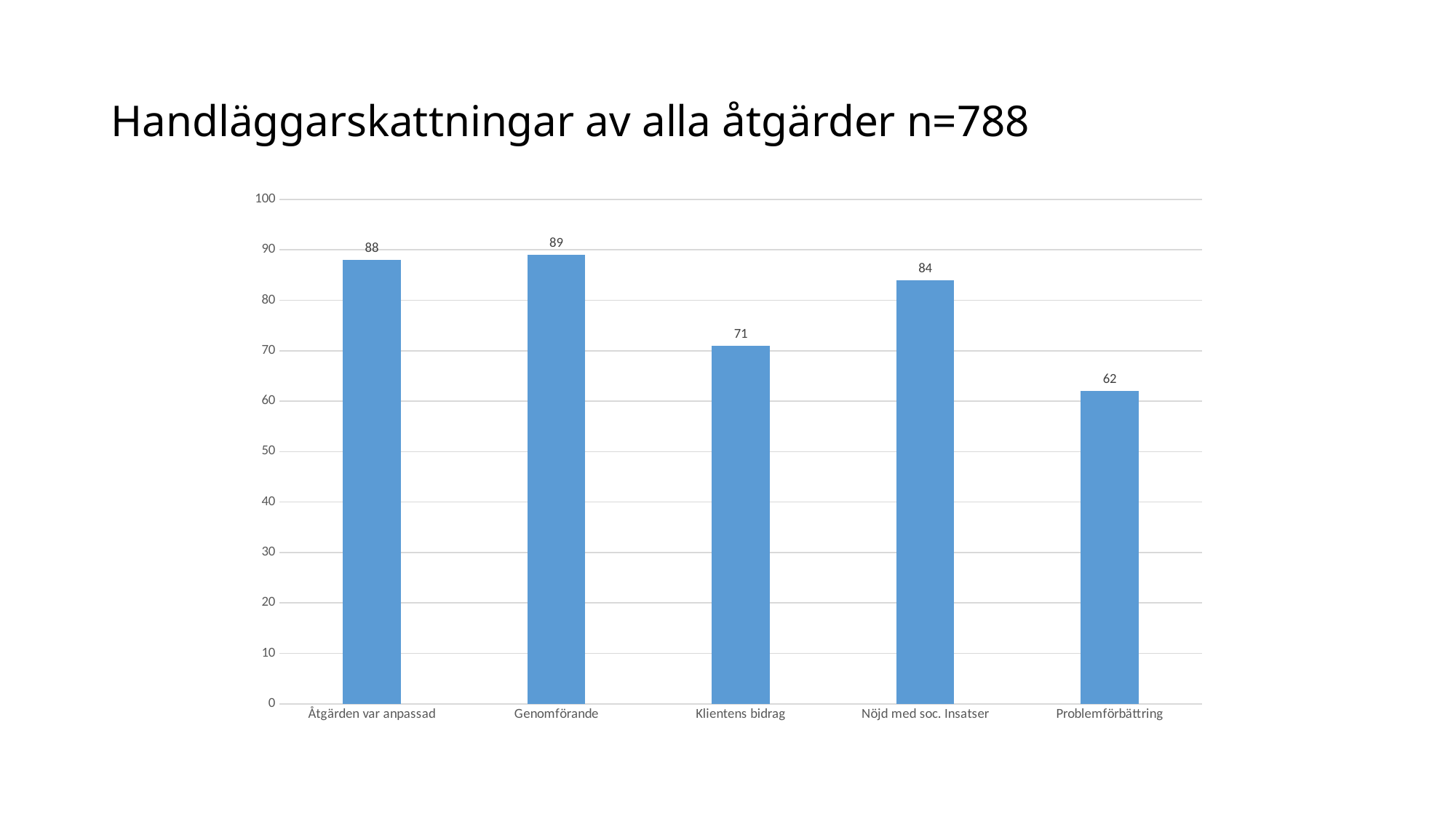
Which is larger, the value for Klientens bidrag or the value for Nöjd med soc. Insatser? Nöjd med soc. Insatser What is the value for Åtgärden var anpassad? 88 What kind of chart is shown on the slide? Bar chart What is the difference between the values for Nöjd med soc. Insatser and Problemförbättring? 22 What is the value for Klientens bidrag? 71 Which category has the lowest value? Problemförbättring How many categories are shown in the chart? 5 What is the value for Problemförbättring? 62 What is the value for Nöjd med soc. Insatser? 84 What is the title of the slide? Handläggarskattningar av alla åtgärder n=788 Which category has the highest value? Genomförande What is the value for Genomförande? 89